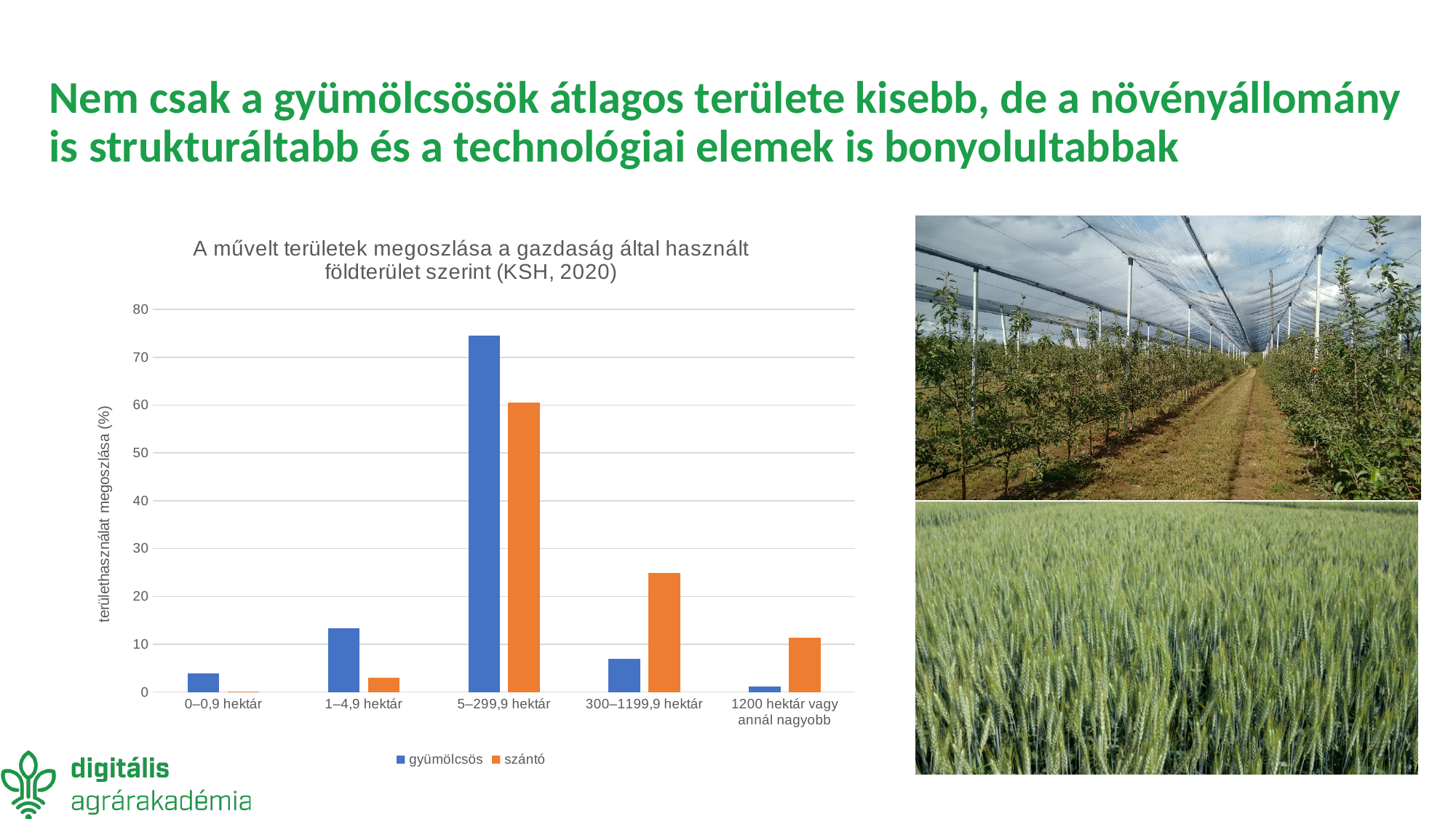
Which category has the lowest value for the gyümölcsös series? 1200 hektár vagy annál nagyobb Which category has the lowest value for the szántó series? 0–0,9 hektár What kind of chart is shown on the slide? bar chart Is the gyümölcsös value for 1–4,9 hektár greater or less than 10? greater How many farm size categories are shown on the x axis of the chart? 5 For the 300–1199,9 hektár category, which series has the larger value, gyümölcsös or szántó? szántó What is the title of the chart? A művelt területek megoszlása a gazdaság által használt földterület szerint (KSH, 2020) For the 1–4,9 hektár category, which series has the larger value, gyümölcsös or szántó? gyümölcsös How many series does the chart legend list? 2 Is the gyümölcsös value for 5–299,9 hektár greater or less than 70? greater Which category has the highest value for the gyümölcsös series? 5–299,9 hektár Is the szántó value for 300–1199,9 hektár greater or less than 20? greater